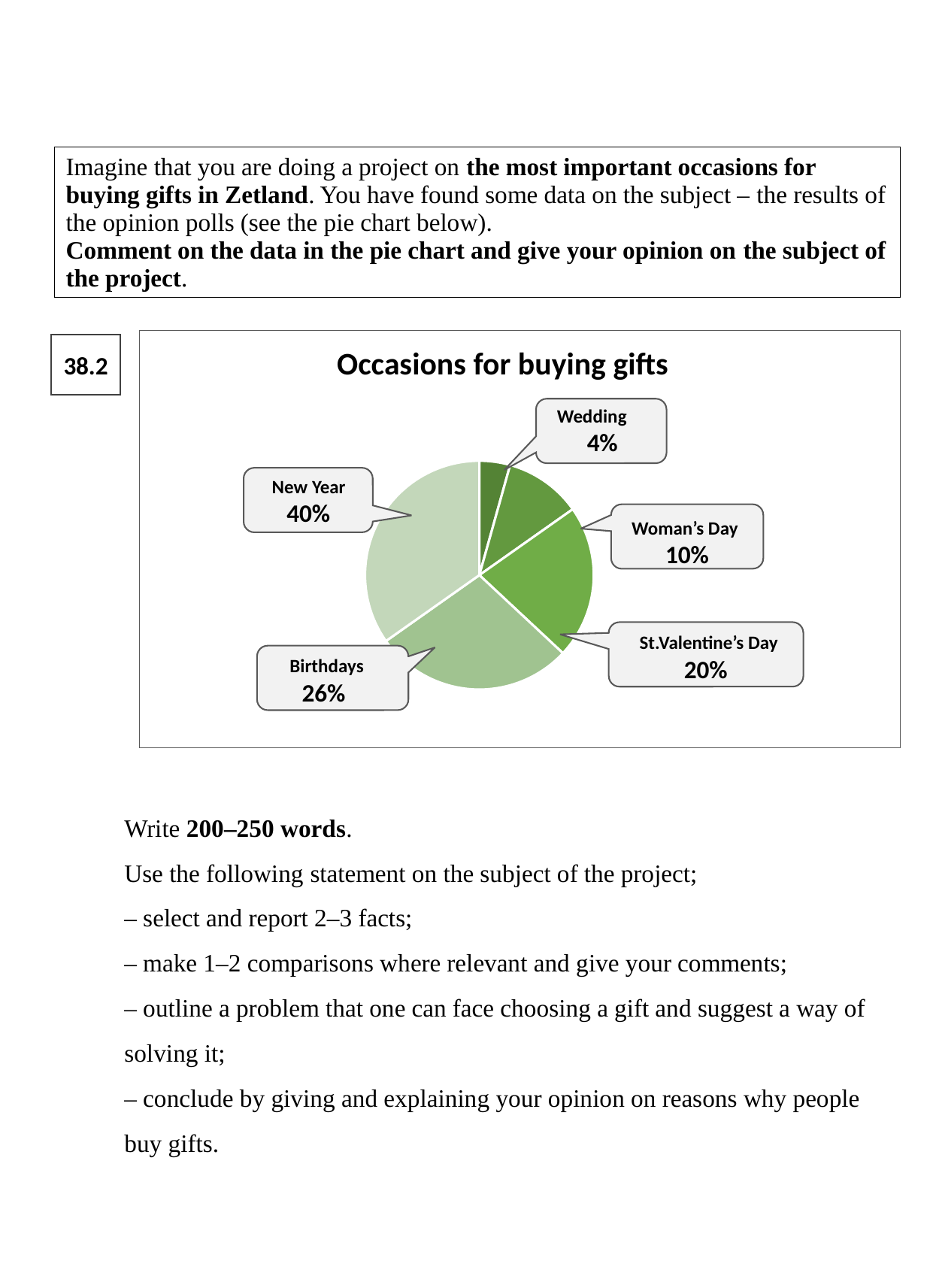
What percentage of the pie is Woman's Day? 10% Which occasion has the largest share of the pie? New Year What percentage of the pie is New Year? 40% What percentage of the pie is Wedding? 4% What is the difference in percentage points between New Year and Birthdays? 14 Which has a larger share, St.Valentine's Day or Woman's Day? St.Valentine's Day What percentage of the pie is St.Valentine's Day? 20% Which occasion has the smallest share of the pie? Wedding What kind of chart is shown on the slide? pie chart What is the title of the chart? Occasions for buying gifts How many occasions are shown in the pie chart? 5 What percentage of the pie is Birthdays? 26%